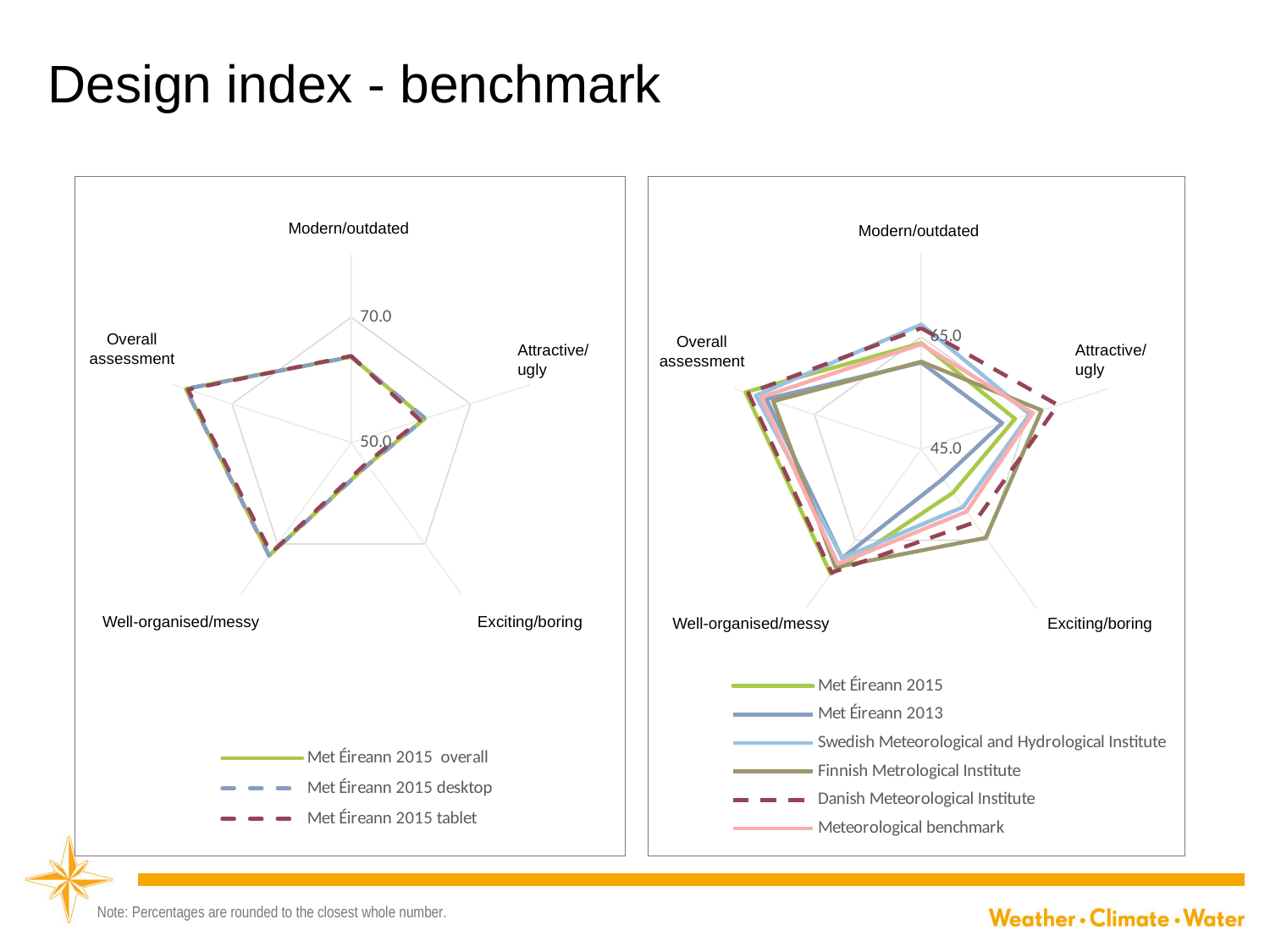
In the left chart, which category has the lowest value for Met Éireann 2015 overall? Exciting/boring How many series does the legend of the left chart list? 3 What kind of chart is the left chart on the slide? Radar chart In the right chart, which series has the lowest value for Attractive/ugly? Met Éireann 2013 In the right chart, which series has the highest value for Exciting/boring? Finnish Metrological Institute Which series in the right chart's legend is drawn with a dashed line? Danish Meteorological Institute In the left chart, is the value for Modern/outdated for Met Éireann 2015 overall greater or less than 50? greater In the right chart, which is larger for Attractive/ugly: Danish Meteorological Institute or Met Éireann 2013? Danish Meteorological Institute How many series does the legend of the right chart list? 6 How many categories (axes) does the left chart have? 5 In the left chart, is the value for Exciting/boring for Met Éireann 2015 overall greater or less than 70? less In the right chart, is the value for Modern/outdated for Met Éireann 2013 greater or less than 65? less